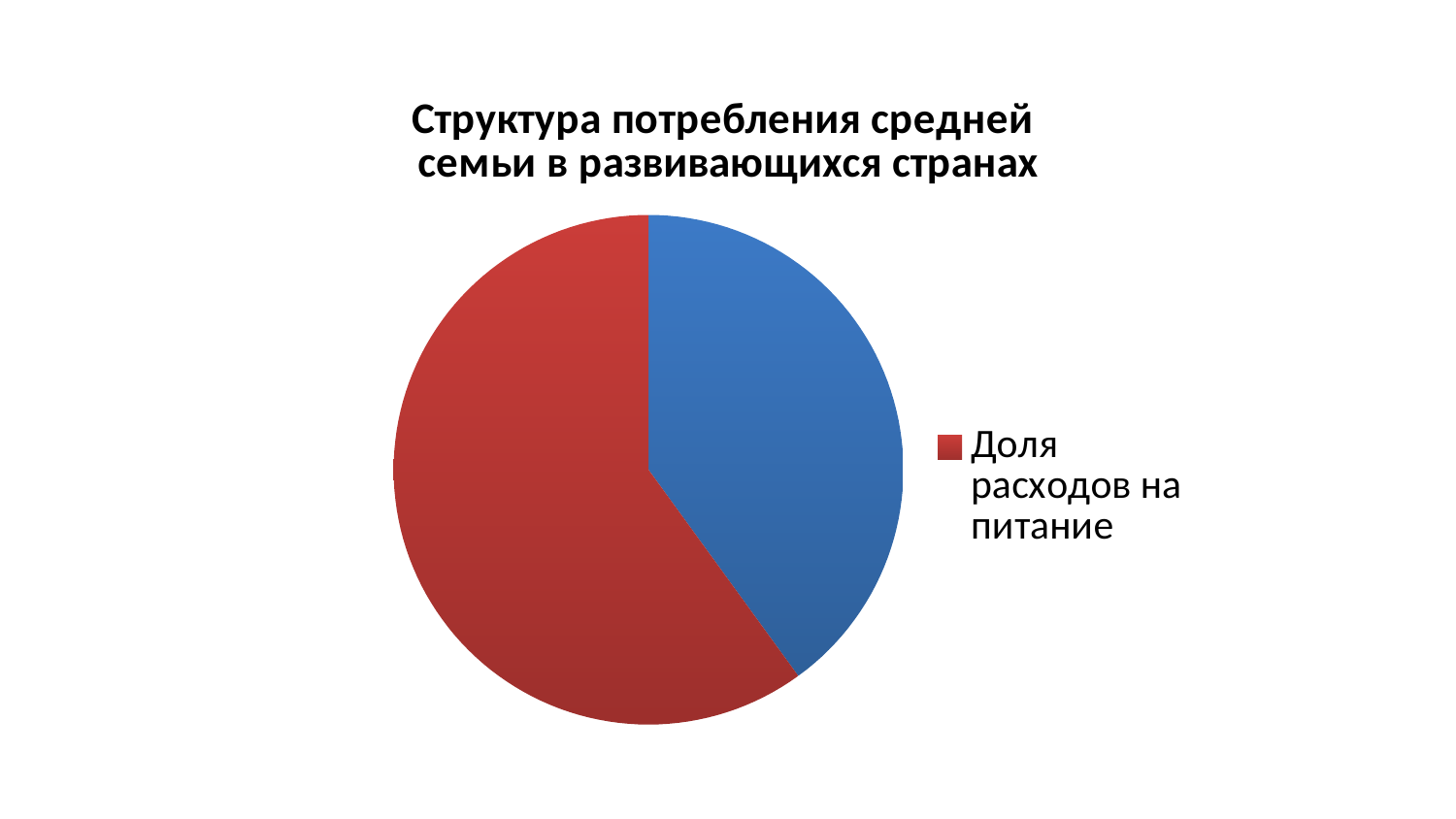
Which slice of the pie chart is the smallest? The blue slice What kind of chart is shown on the slide? Pie chart What is the title of the pie chart? Структура потребления средней семьи в развивающихся странах How many entries does the legend of the pie chart list? 1 Is the slice labelled "Доля расходов на питание" larger or smaller than half of the pie? Larger Which slice of the pie chart is larger, the red one or the blue one? The red one What colour is the slice labelled "Доля расходов на питание" in the legend? Red How many slices does the pie chart have? 2 Which slice of the pie chart is the largest? Доля расходов на питание (red)